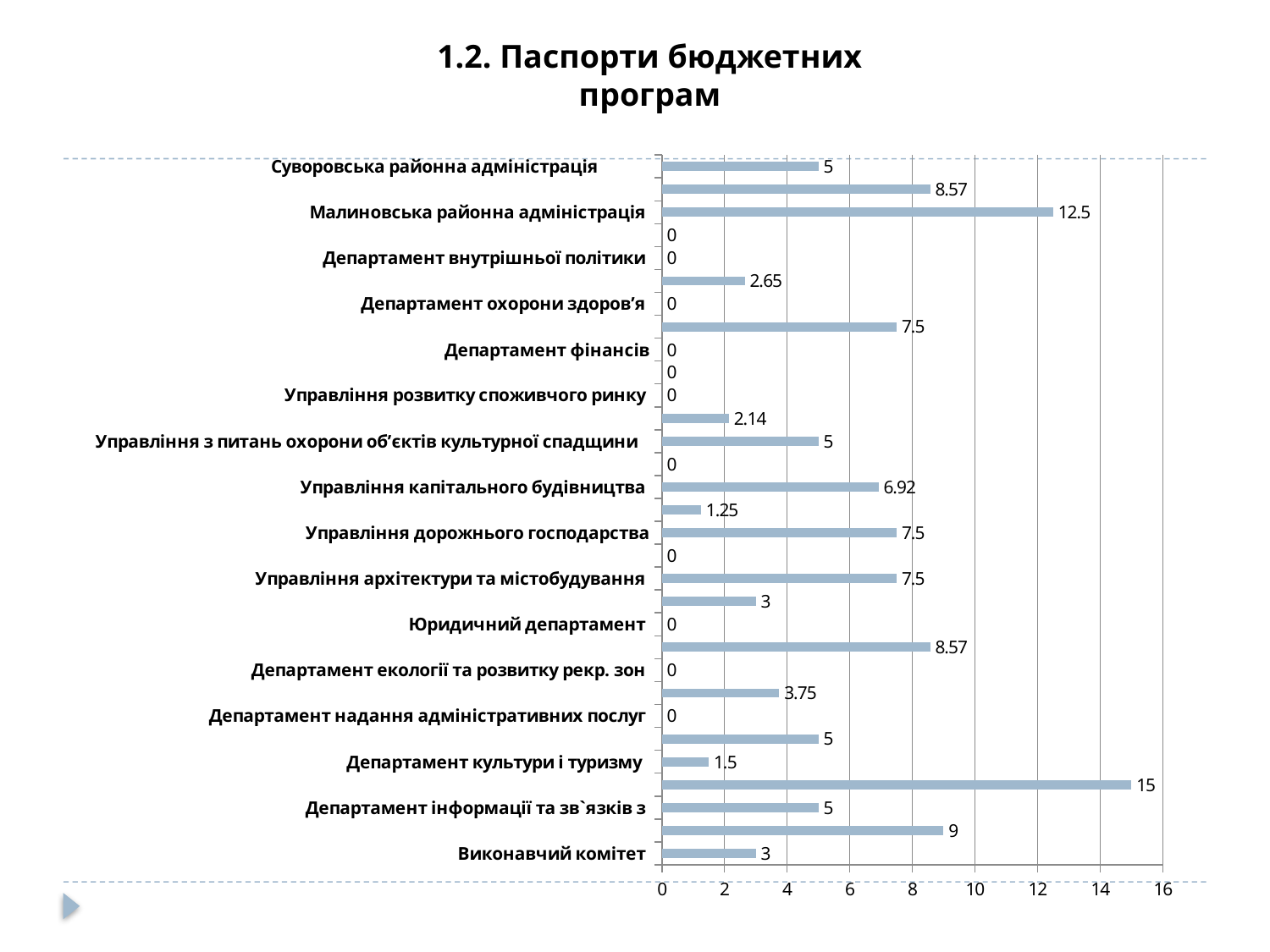
What is the value for Департамент культури і туризму? 1.5 What is the title of the chart? 1.2. Паспорти бюджетних програм What is the value for Управління капітального будівництва? 6.92 Which is larger, the value for Управління архітектури та містобудування or the value for Виконавчий комітет? Управління архітектури та містобудування What is the value for Управління дорожнього господарства? 7.5 What is the difference between the values for Малиновська районна адміністрація and Суворовська районна адміністрація? 7.5 What is the value for Виконавчий комітет? 3 What is the value for Департамент фінансів? 0 What type of chart is shown on the slide? bar chart Is the value for Малиновська районна адміністрація greater or less than 10? greater What is the value for Суворовська районна адміністрація? 5 What is the value for Малиновська районна адміністрація? 12.5